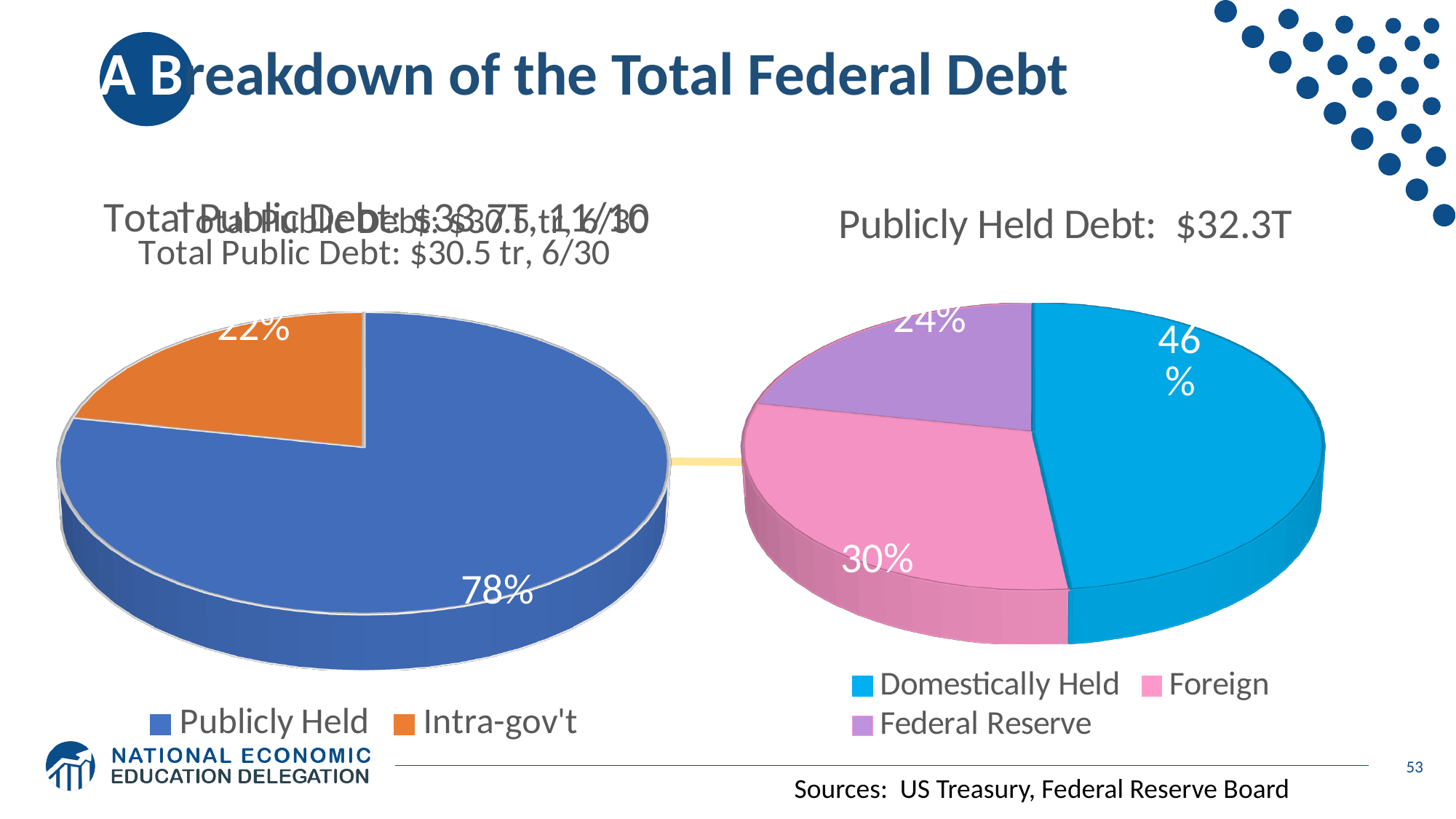
In the 'Publicly Held Debt: $32.3T' chart, what share is Federal Reserve? 24% In the left pie chart, which slice is the largest? Publicly Held In the 'Publicly Held Debt: $32.3T' chart, what share is Foreign? 30% How many categories does the legend of the 'Publicly Held Debt: $32.3T' chart list? 3 In the left pie chart, what share is labelled for Publicly Held? 78% What type of chart is the 'Publicly Held Debt: $32.3T' chart? Pie chart In the left pie chart, how many slices are there? 2 In the 'Publicly Held Debt: $32.3T' chart, which is larger, Foreign or Federal Reserve? Foreign In the left pie chart, what share is labelled for Intra-gov't? 22% In the 'Publicly Held Debt: $32.3T' chart, what share is Domestically Held? 46% In the 'Publicly Held Debt: $32.3T' chart, which category has the smallest share? Federal Reserve In the left pie chart, what is the difference in percentage points between Publicly Held and Intra-gov't? 56